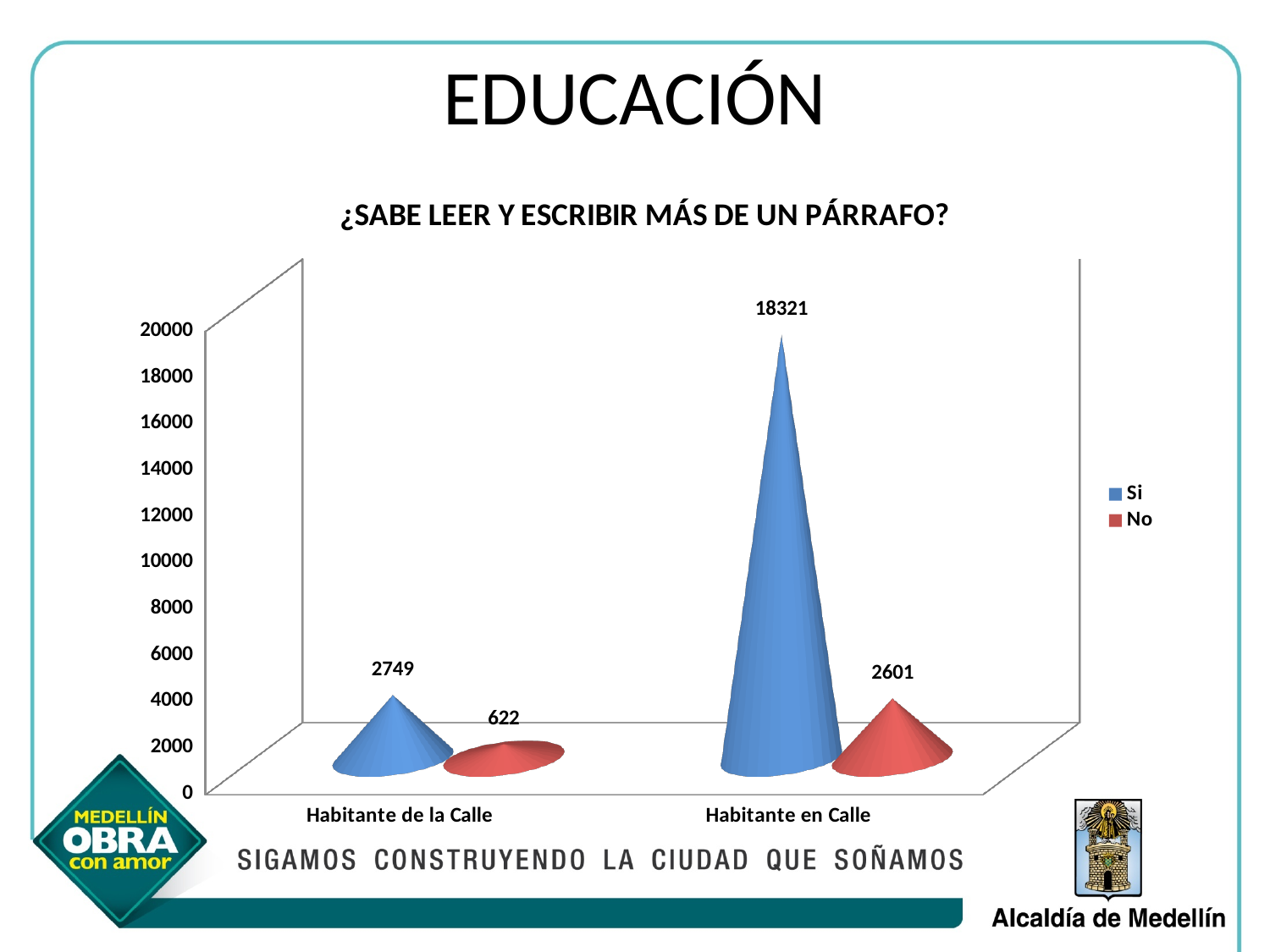
Which is larger: the "Si" value for Habitante de la Calle or the "No" value for Habitante en Calle? Si for Habitante de la Calle What is the title of the chart? ¿SABE LEER Y ESCRIBIR MÁS DE UN PÁRRAFO? What is the value for "No" for Habitante en Calle? 2601 Which category has the lowest "No" value? Habitante de la Calle What is the difference between the "Si" and "No" values for Habitante de la Calle? 2127 Which category has the highest "Si" value? Habitante en Calle How many categories are shown on the x axis? 2 What is the value for "Si" for Habitante en Calle? 18321 How many series does the legend list? 2 What is the difference between the "Si" and "No" values for Habitante en Calle? 15720 What is the value for "Si" for Habitante de la Calle? 2749 What is the value for "No" for Habitante de la Calle? 622